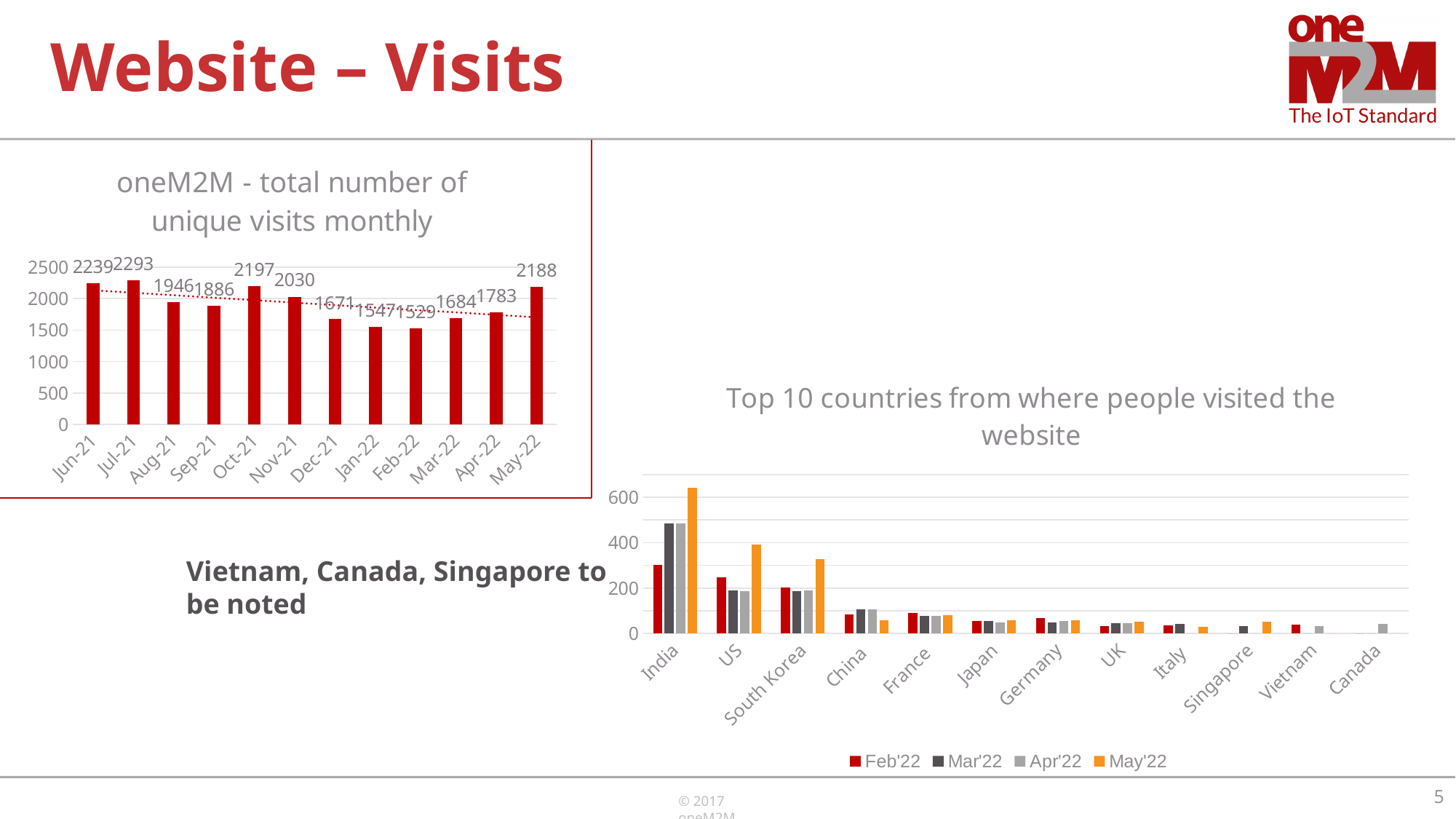
In the chart 'oneM2M - total number of unique visits monthly', what is the value for Dec-21? 1671 In the chart 'Top 10 countries from where people visited the website', is the May'22 value for India greater or less than 600? greater In the chart 'oneM2M - total number of unique visits monthly', what is the difference between the values for May-22 and Apr-22? 405 What are the legend entries in the chart 'Top 10 countries from where people visited the website'? Feb'22, Mar'22, Apr'22, May'22 How many months are shown in the chart 'oneM2M - total number of unique visits monthly'? 12 In the chart 'Top 10 countries from where people visited the website', which country has the highest May'22 bar? India In the chart 'oneM2M - total number of unique visits monthly', which month has the highest value? Jul-21 What kind of chart is 'oneM2M - total number of unique visits monthly'? Bar chart In the chart 'oneM2M - total number of unique visits monthly', which month has the lowest value? Feb-22 In the chart 'oneM2M - total number of unique visits monthly', which is larger, the value for Oct-21 or Nov-21? Oct-21 In the chart 'oneM2M - total number of unique visits monthly', what is the value for Jul-21? 2293 How many series does the legend list in the chart 'Top 10 countries from where people visited the website'? 4